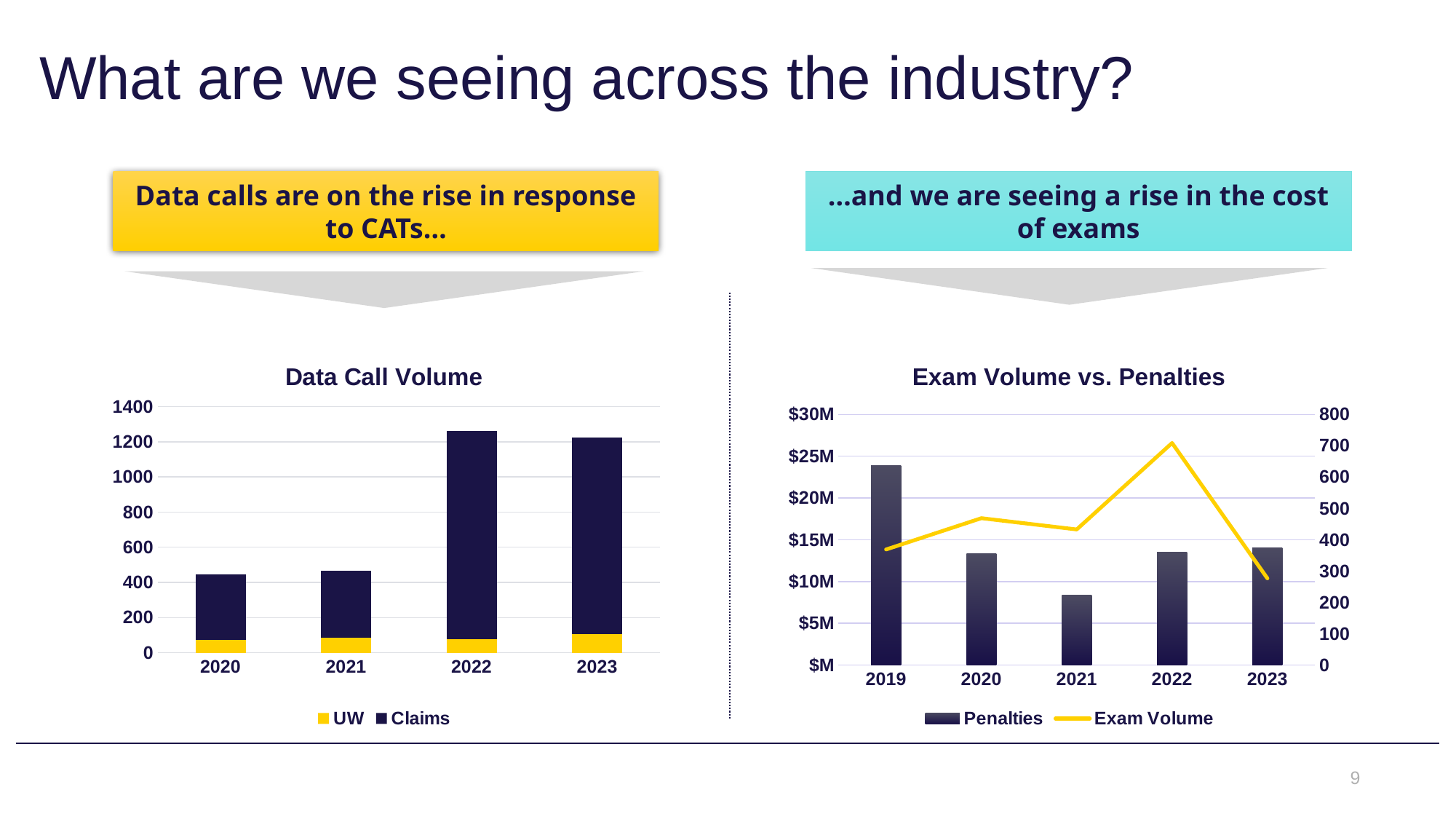
In the Exam Volume vs. Penalties chart, is the Penalties value for 2019 greater or less than $20M? greater In the Exam Volume vs. Penalties chart, which year has the lowest Penalties? 2021 What kind of chart is the Data Call Volume chart? Stacked bar chart In the Exam Volume vs. Penalties chart, how many years are shown on the x axis? 5 In the Exam Volume vs. Penalties chart, which year has the highest Exam Volume? 2022 In the Data Call Volume chart, how many years are shown on the x axis? 4 In the Data Call Volume chart, is the total for 2022 greater or less than 1200? greater In the Data Call Volume chart, is the total for 2020 greater or less than 600? less In the Data Call Volume chart, which series is shown in yellow? UW In the Data Call Volume chart, how many series does the legend list? 2 In the Exam Volume vs. Penalties chart, which year has the highest Penalties? 2019